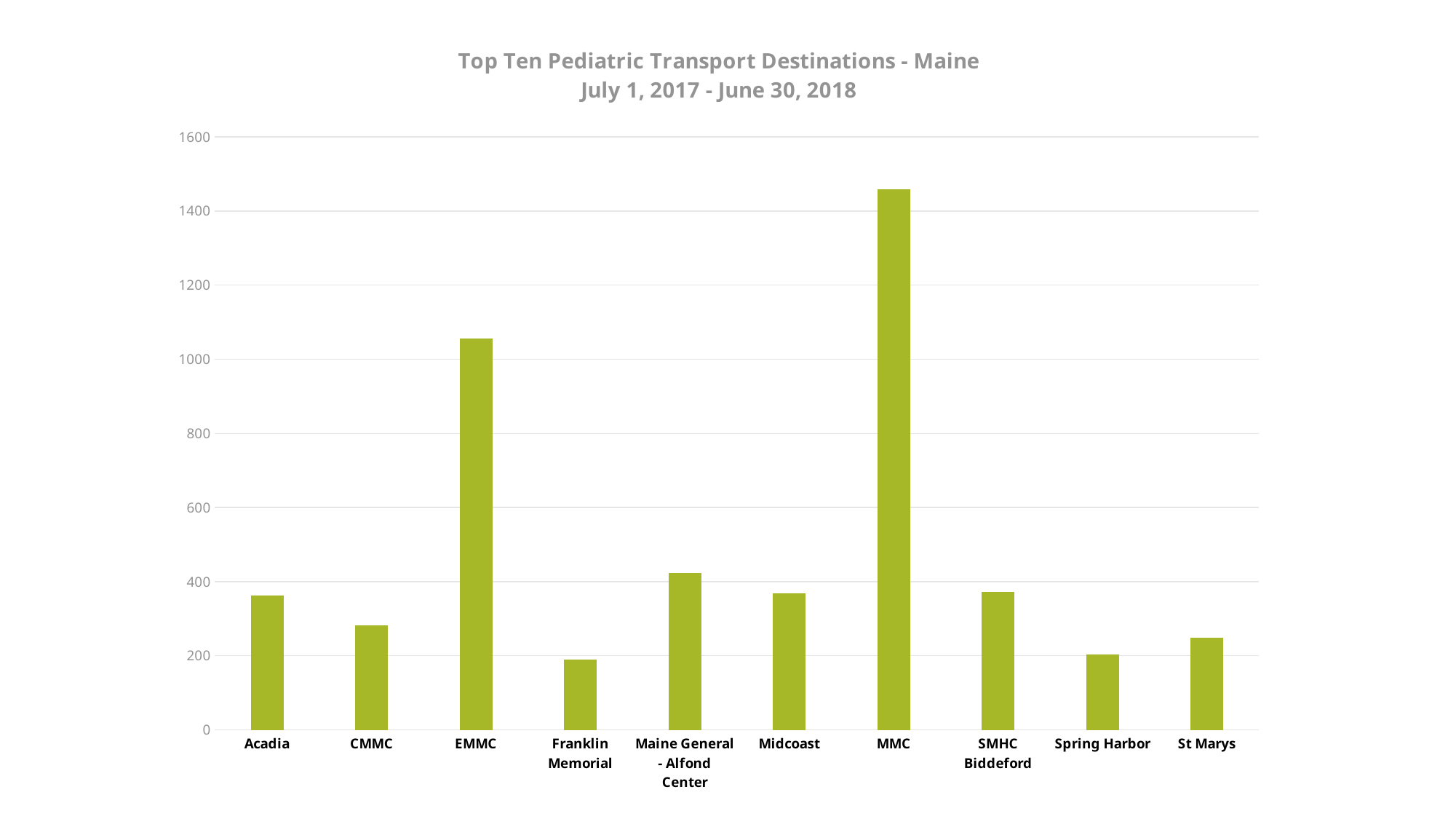
Which is larger, the value for EMMC or the value for MMC? MMC Is the value for CMMC greater or less than 400? less What kind of chart is shown on the slide? bar chart What time period does the chart title say the data covers? July 1, 2017 - June 30, 2018 Is the value for EMMC greater or less than 1000? greater Is the value for MMC greater or less than 1400? greater Which destination has the highest number of pediatric transports? MMC Which is larger, the value for Maine General - Alfond Center or the value for Midcoast? Maine General - Alfond Center Which is larger, the value for Acadia or the value for CMMC? Acadia How many destinations are shown on the x axis of the chart? 10